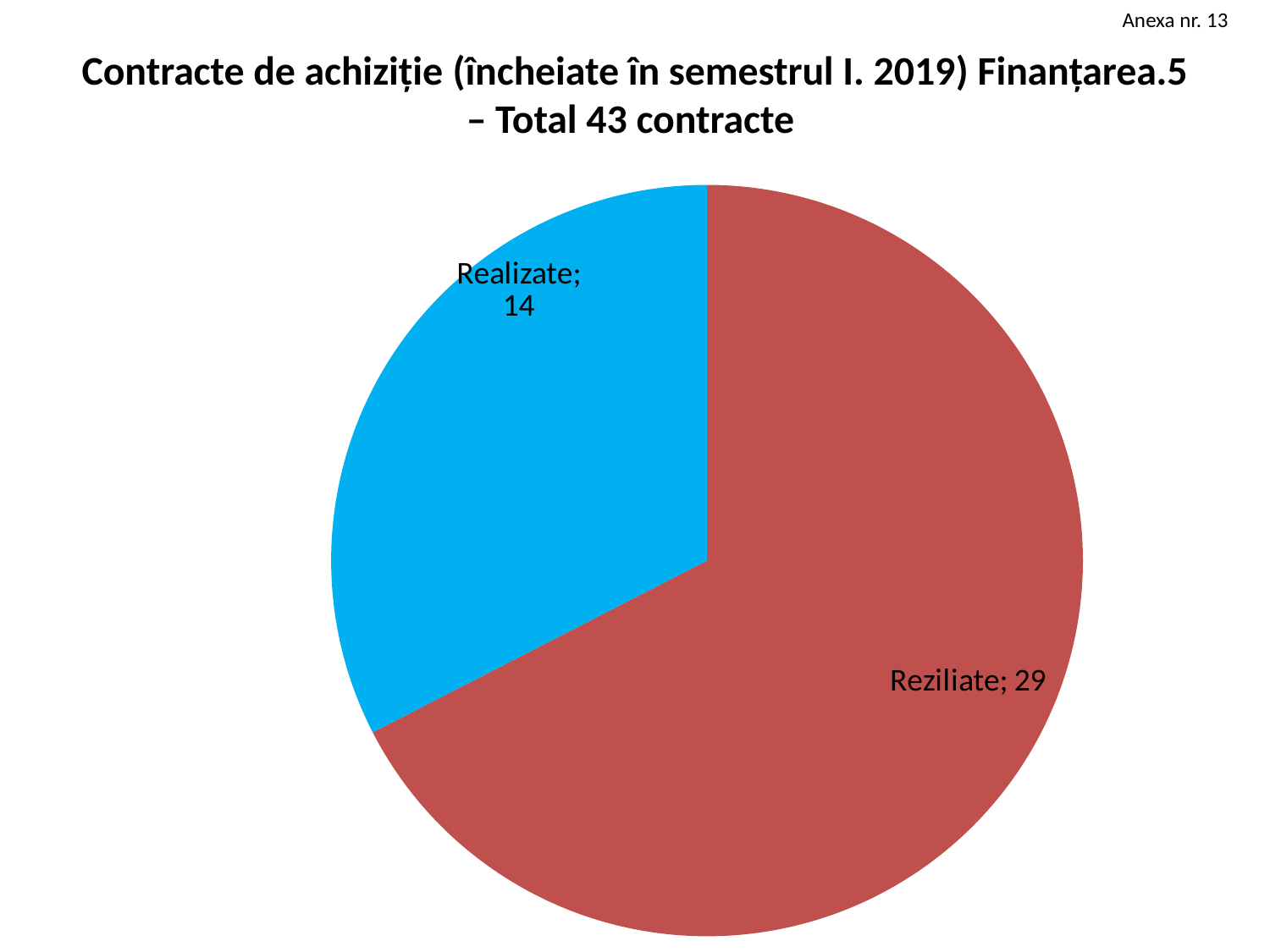
What type of chart is shown on the slide? pie chart What is the title of the chart? Contracte de achiziție (încheiate în semestrul I. 2019) Finanțarea.5 – Total 43 contracte Which is larger, the value for Realizate or the value for Reziliate? Reziliate Which category has the largest slice of the pie? Reziliate What share of the total contracts does the Reziliate slice represent, to the nearest whole percent? 67% Which category has the smallest slice of the pie? Realizate How many slices does the pie chart have? 2 What is the total number of contracts shown in the pie chart? 43 What colour is the Realizate slice? blue How many contracts are labelled Reziliate? 29 How many contracts are labelled Realizate? 14 What is the difference between the number of Reziliate and Realizate contracts? 15